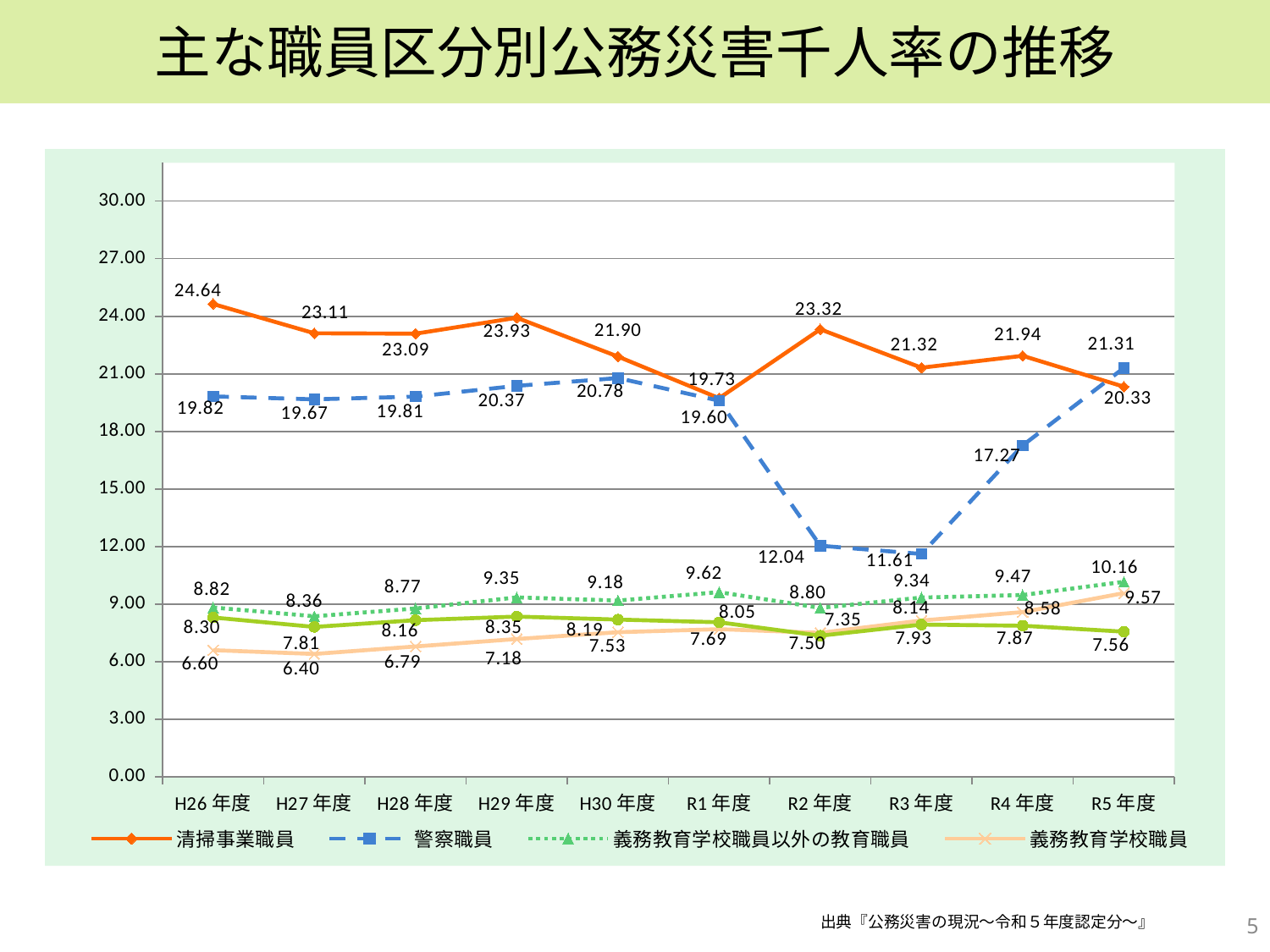
In which fiscal year is the value for 清掃事業職員 highest? H26年度 What is the difference between the 清掃事業職員 values in H26年度 and R5年度? 4.31 In R5年度, which is larger: the value for 警察職員 or the value for 清掃事業職員? 警察職員 What kind of chart is shown on the slide? line chart Is the value for 警察職員 in R2年度 greater or less than 15.00? less What is the value for 清掃事業職員 in H26年度? 24.64 What is the value for 義務教育学校職員 in H26年度? 6.60 In which fiscal year is the value for 警察職員 lowest? R3年度 How many series does the legend list? 4 What is the value for 警察職員 in R3年度? 11.61 How many fiscal years are plotted along the x axis? 10 What is the value for 義務教育学校職員以外の教育職員 in R5年度? 10.16